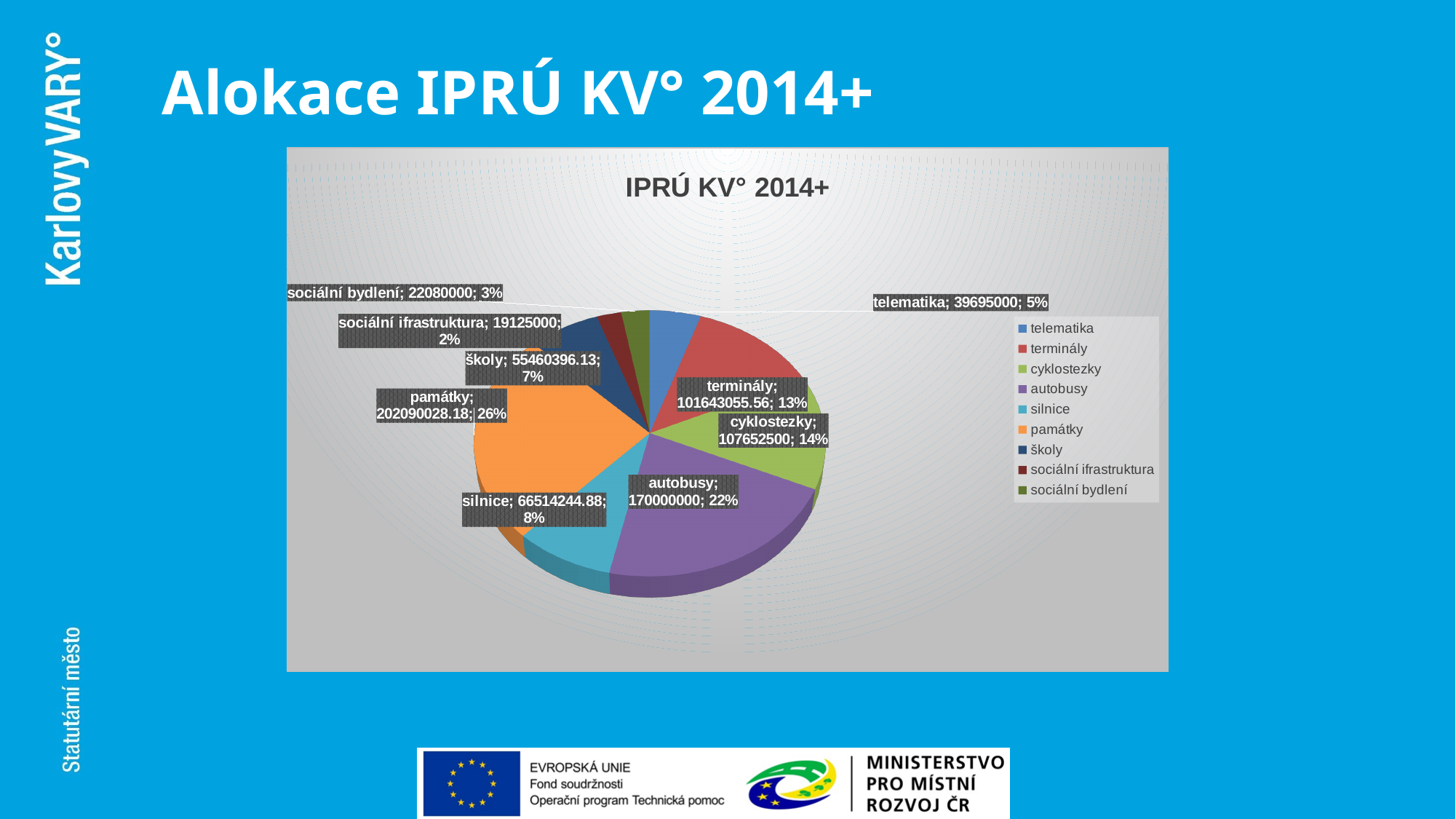
What is the title of the chart? IPRÚ KV° 2014+ Which is larger, the value for autobusy or the value for cyklostezky? autobusy How many categories does the pie chart have? 9 What is the value for silnice? 66514244.88 What share of the pie does terminály represent? 13% What share of the pie does cyklostezky represent? 14% Which category has the smallest slice of the pie? sociální ifrastruktura Which category has the largest slice of the pie? památky What is the difference between the value for autobusy and the value for telematika? 130305000 What kind of chart is shown on the slide? pie chart What is the value for památky? 202090028.18 What is the value for autobusy? 170000000